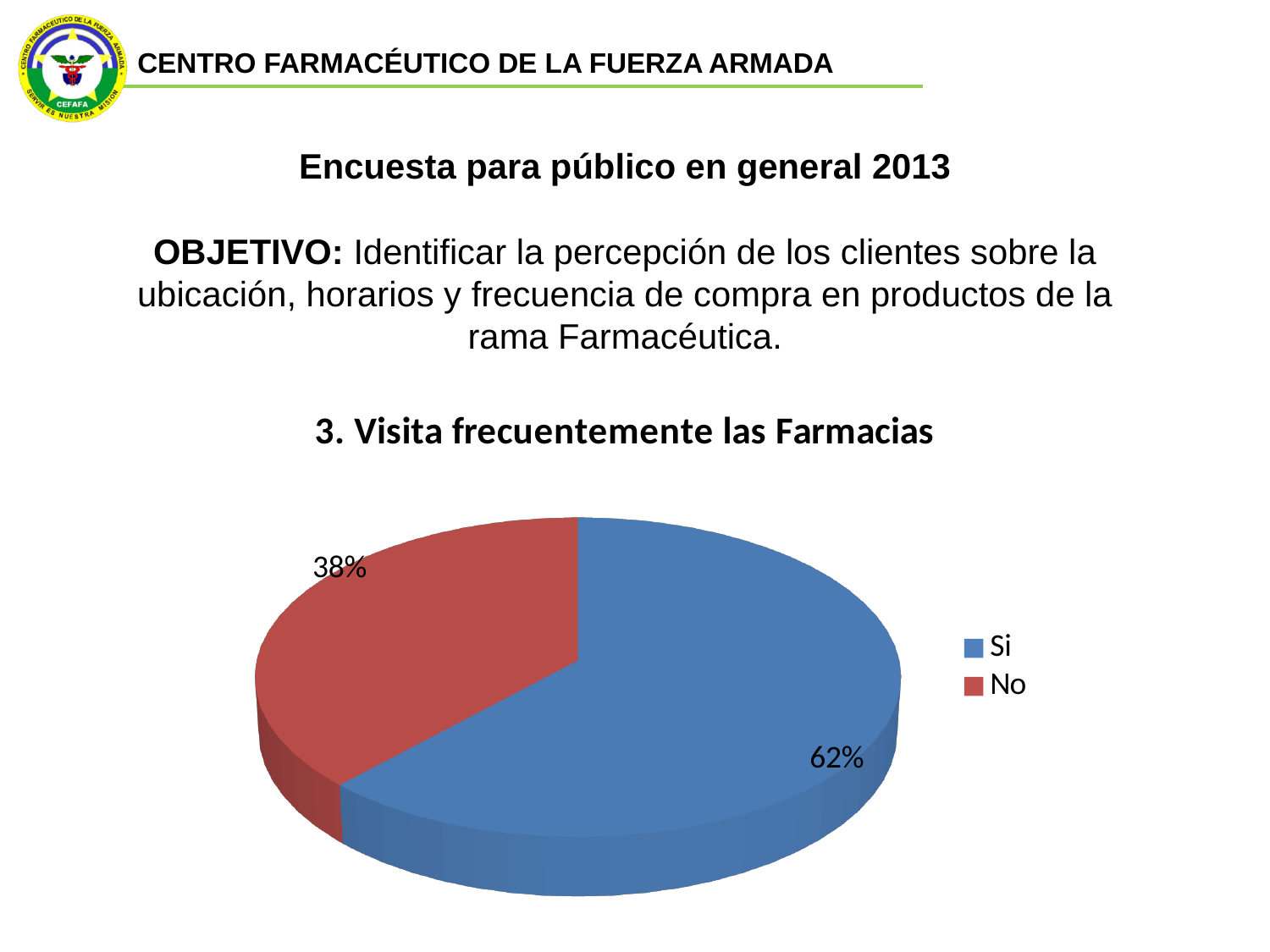
Which slice is larger, "Si" or "No"? Si What colour is the "No" slice in the pie chart? Red What kind of chart is shown on the slide? Pie chart Which response has the smallest share of the pie? No What is the difference in percentage points between the "Si" and "No" slices? 24 How many entries does the legend list? 2 How many slices does the pie chart have? 2 Which response has the largest share of the pie? Si What is the title of the chart? 3. Visita frecuentemente las Farmacias What share of the pie does the "No" slice represent? 38% What percentage of respondents answered "Si" to visiting pharmacies frequently? 62% What percentage of respondents answered "No"? 38%